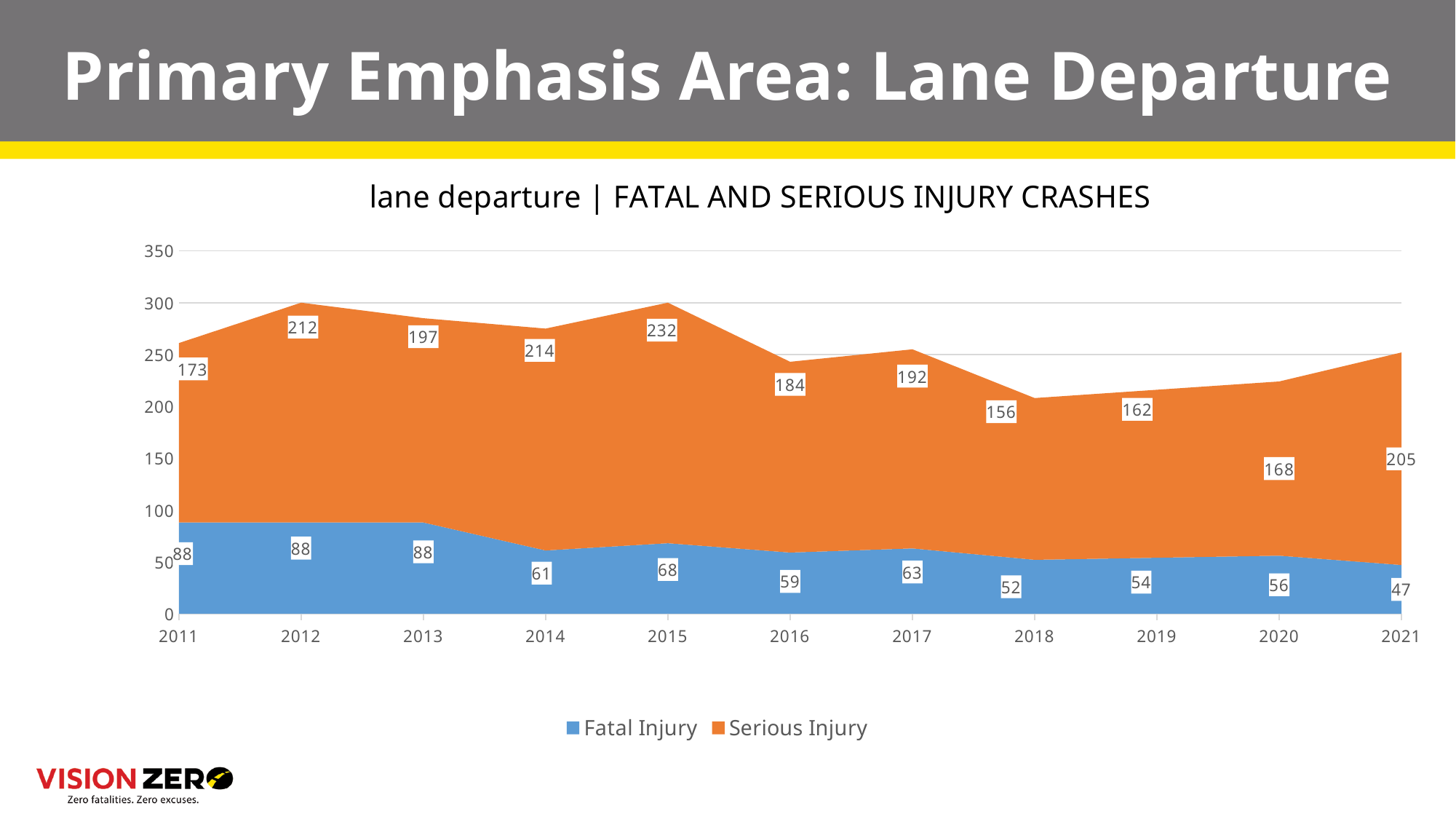
What is the Fatal Injury value for 2021? 47 What type of chart is shown on the slide? Stacked area chart Which is larger, the Serious Injury value for 2012 or for 2013? 2012 How many years are plotted along the x axis? 11 Which year has the lowest Fatal Injury value? 2021 What is the total of Fatal Injury and Serious Injury crashes in 2015? 300 How many series does the legend list? 2 What is the Serious Injury value for 2015? 232 Which year has the highest Serious Injury value? 2015 What is the title of the chart? lane departure | FATAL AND SERIOUS INJURY CRASHES What is the Serious Injury value for 2018? 156 What is the difference between the Serious Injury and Fatal Injury values in 2015? 164